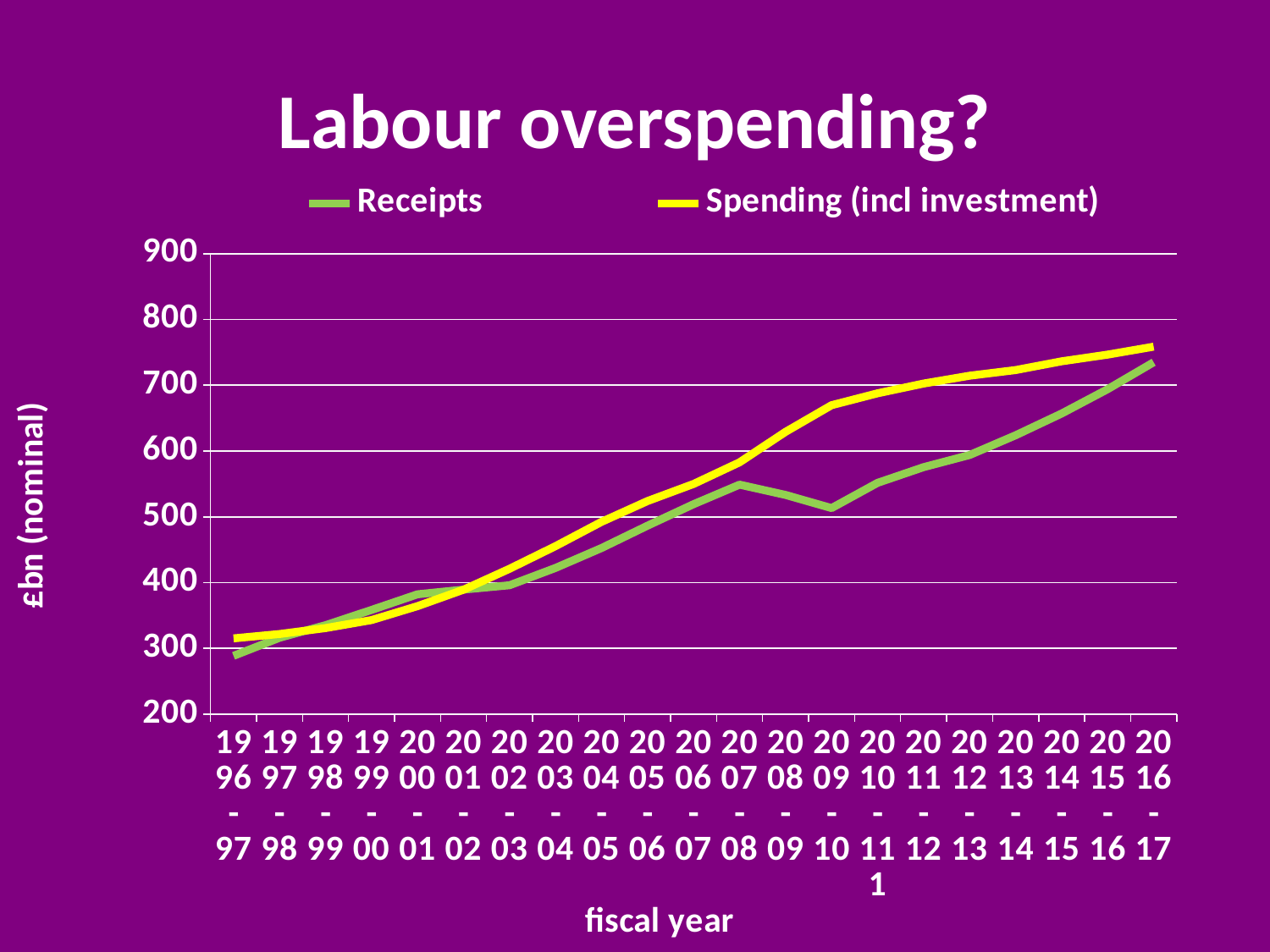
Is the value for Receipts in 2007-08 greater or less than 500? greater What type of chart is shown on the slide? line chart Does the Spending (incl investment) line rise or fall from 1996-97 to 2016-17? rise In 2009-10, which is larger: Receipts or Spending (incl investment)? Spending (incl investment) How many fiscal years are plotted along the x axis? 21 Is the value for Receipts in 1996-97 greater or less than 300? less What is the label of the y axis? £bn (nominal) Is the value for Spending (incl investment) in 2009-10 greater or less than 600? greater What is the title of the chart? Labour overspending? How many series does the legend list? 2 In which fiscal year is Spending (incl investment) highest? 2016-17